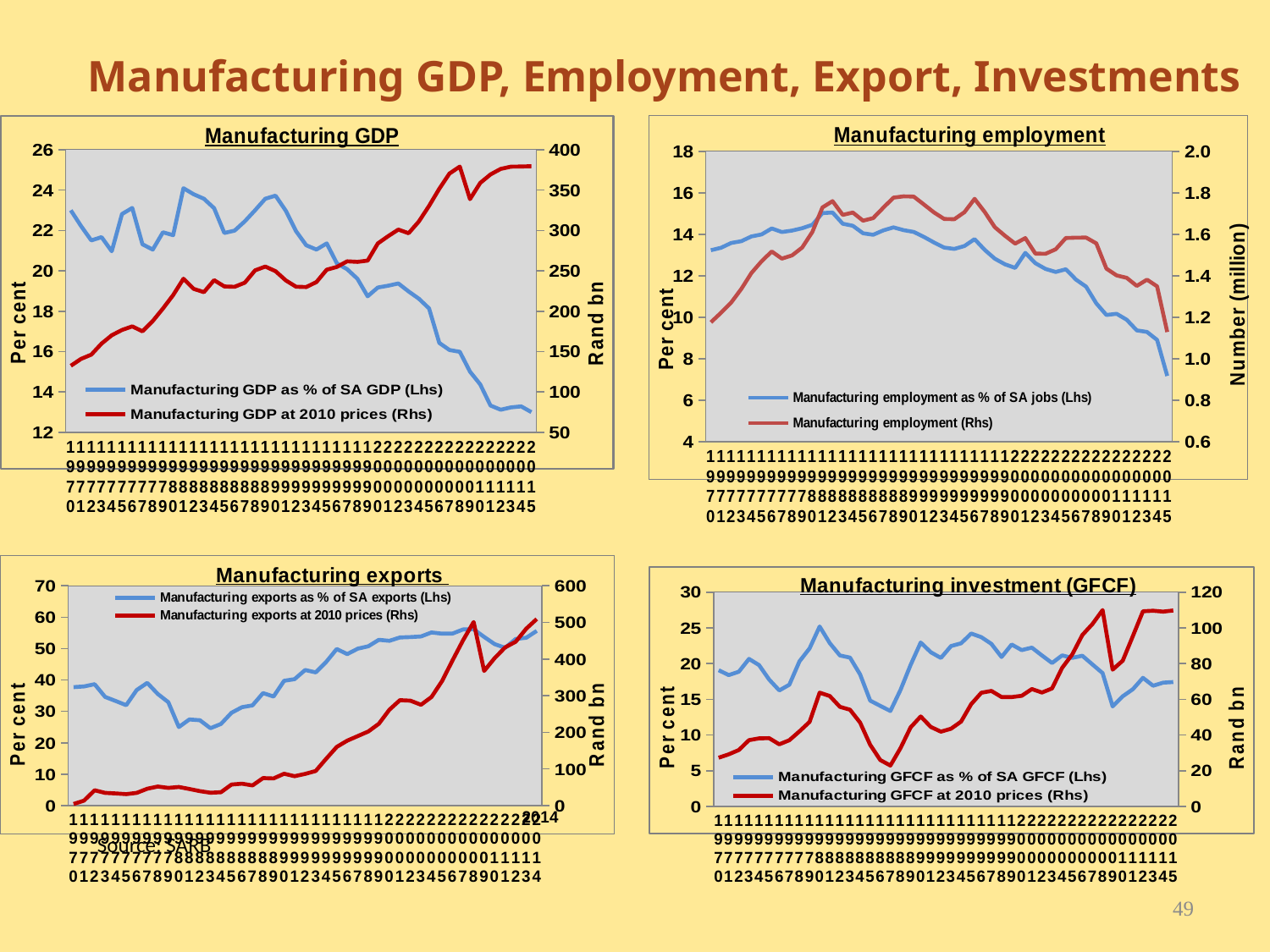
In the Manufacturing GDP chart, does the series 'Manufacturing GDP as % of SA GDP (Lhs)' rise or fall overall from 1970 to 2015? fall In the Manufacturing employment chart, does 'Manufacturing employment as % of SA jobs (Lhs)' rise or fall overall from 1970 to 2015? fall In the Manufacturing exports chart, does 'Manufacturing exports at 2010 prices (Rhs)' rise or fall overall across the period? rise What is the label on the right-hand vertical axis of the Manufacturing employment chart? Number (million) How many charts are shown on the slide? 4 How many series does the legend of the Manufacturing employment chart list? 2 What source is cited at the bottom of the slide? SARB In the Manufacturing exports chart, is the final value of 'Manufacturing exports at 2010 prices (Rhs)' greater or less than 400? greater In the Manufacturing investment (GFCF) chart, is the final value of 'Manufacturing GFCF at 2010 prices (Rhs)' greater or less than 100? greater What kind of chart is the Manufacturing GDP chart? line chart In the Manufacturing employment chart, is the value of 'Manufacturing employment as % of SA jobs (Lhs)' at the end of the series greater or less than 8? less